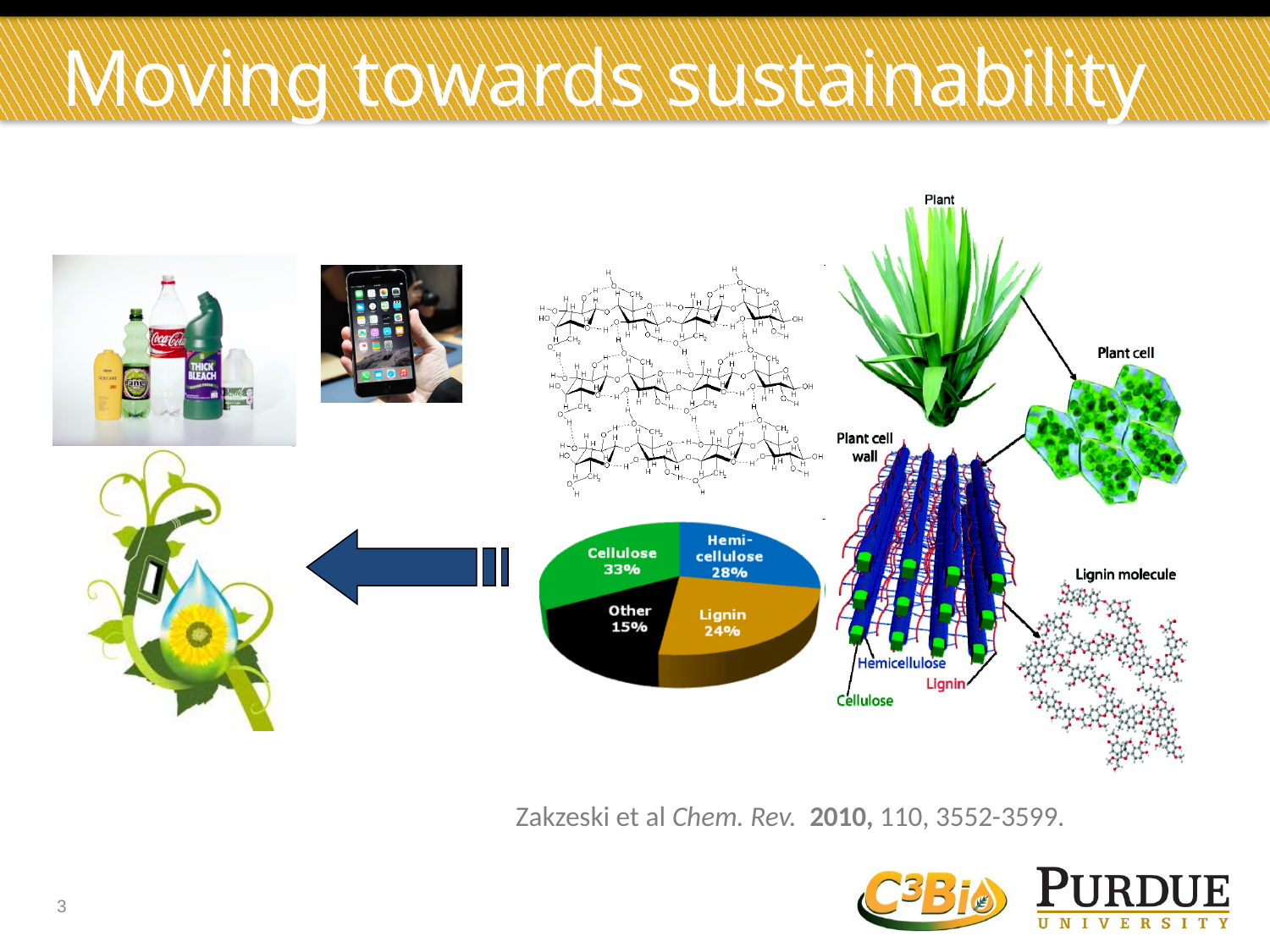
Which slice of the pie chart is the smallest? Other Which is larger in the pie chart, Hemicellulose or Lignin? Hemicellulose What is the difference between the Hemicellulose and Other values in the pie chart? 13% What is the difference between the Cellulose and Lignin values in the pie chart? 9% What is the value for Cellulose in the pie chart? 33% What is the value for Hemicellulose in the pie chart? 28% Which slice of the pie chart is the largest? Cellulose What is the value for Lignin in the pie chart? 24% What kind of chart is shown on the slide? pie chart How many slices does the pie chart have? 4 What colour is the Cellulose slice in the pie chart? green What is the value for Other in the pie chart? 15%